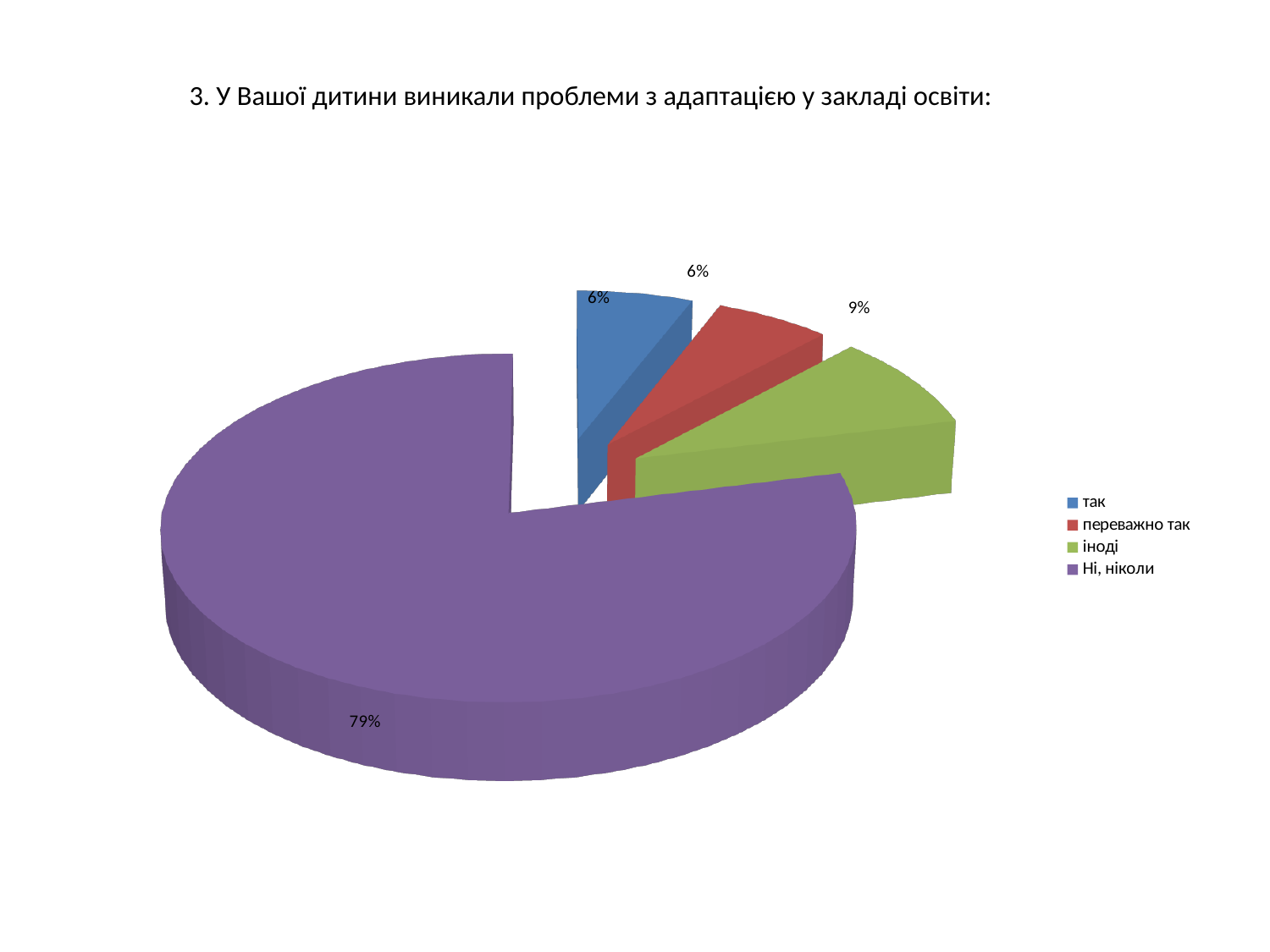
What percentage of the pie is the 'Ні, ніколи' slice? 79% What is the difference in percentage points between the 'Ні, ніколи' slice and the 'іноді' slice? 70 What colour is the 'Ні, ніколи' slice? purple What is the title of the chart? 3. У Вашої дитини виникали проблеми з адаптацією у закладі освіти: Which slice is larger, 'іноді' or 'так'? іноді How many entries does the legend list? 4 What kind of chart is shown on the slide? pie chart How many slices does the pie chart have? 4 Which category has the largest share of the pie? Ні, ніколи What percentage of the pie is the 'іноді' slice? 9% What percentage of the pie is the 'переважно так' slice? 6% What percentage of the pie is the 'так' slice? 6%